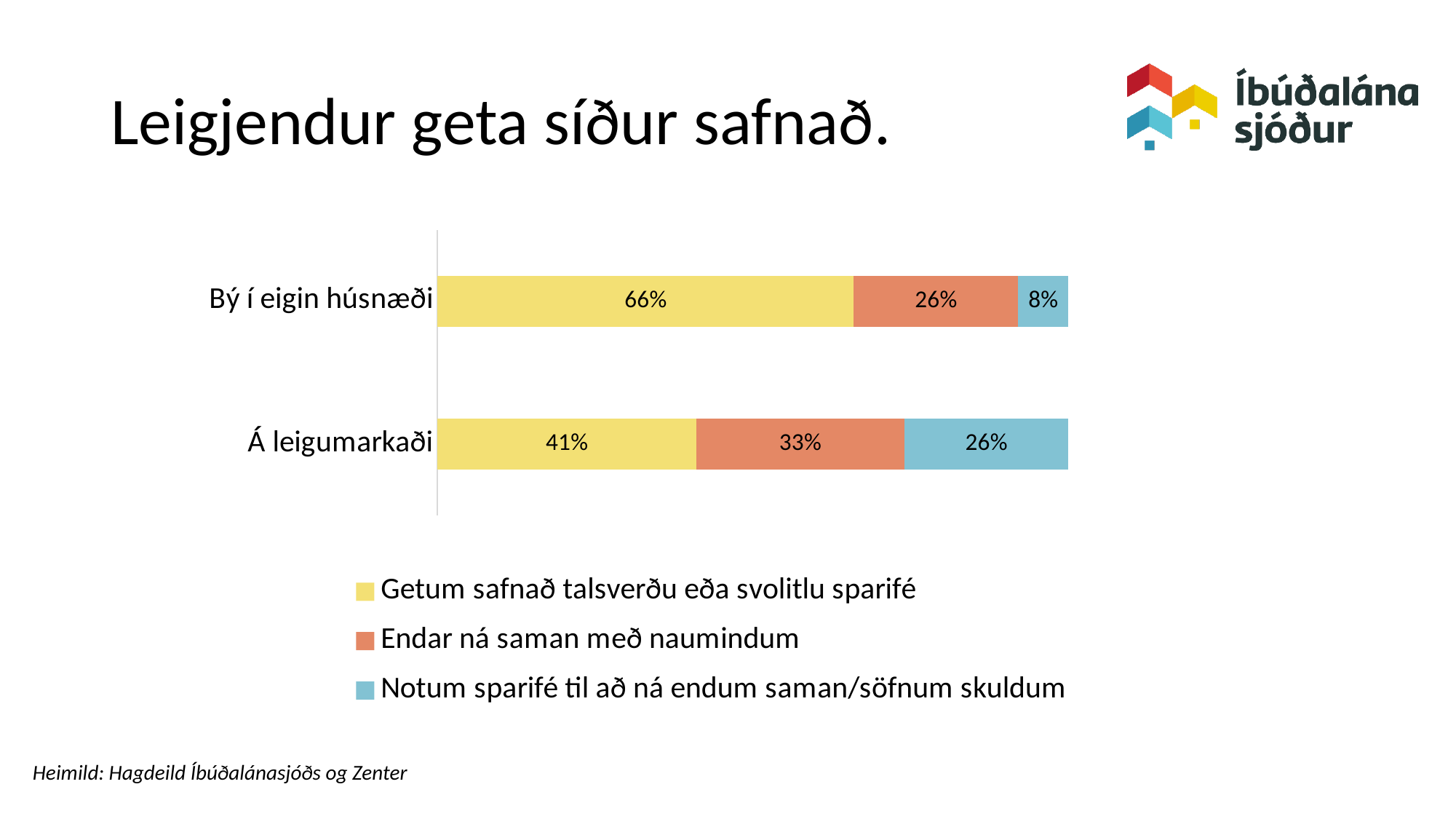
Which is larger: the "Endar ná saman með naumindum" share for "Á leigumarkaði" or for "Bý í eigin húsnæði"? Á leigumarkaði How many series does the legend list? 3 What colour represents "Endar ná saman með naumindum" in the chart? Orange How many categories are shown on the chart? 2 What percentage of "Á leigumarkaði" respondents answered "Endar ná saman með naumindum"? 33% What percentage of "Á leigumarkaði" respondents answered "Notum sparifé til að ná endum saman/söfnum skuldum"? 26% Which category has the higher share for "Getum safnað talsverðu eða svolitlu sparifé"? Bý í eigin húsnæði What kind of chart is shown on the slide? Stacked bar chart What percentage of "Bý í eigin húsnæði" respondents answered "Notum sparifé til að ná endum saman/söfnum skuldum"? 8% What percentage of "Bý í eigin húsnæði" respondents answered "Getum safnað talsverðu eða svolitlu sparifé"? 66% Which category has the lower share for "Notum sparifé til að ná endum saman/söfnum skuldum"? Bý í eigin húsnæði What is the difference between the "Getum safnað talsverðu eða svolitlu sparifé" shares for "Bý í eigin húsnæði" and "Á leigumarkaði"? 25%